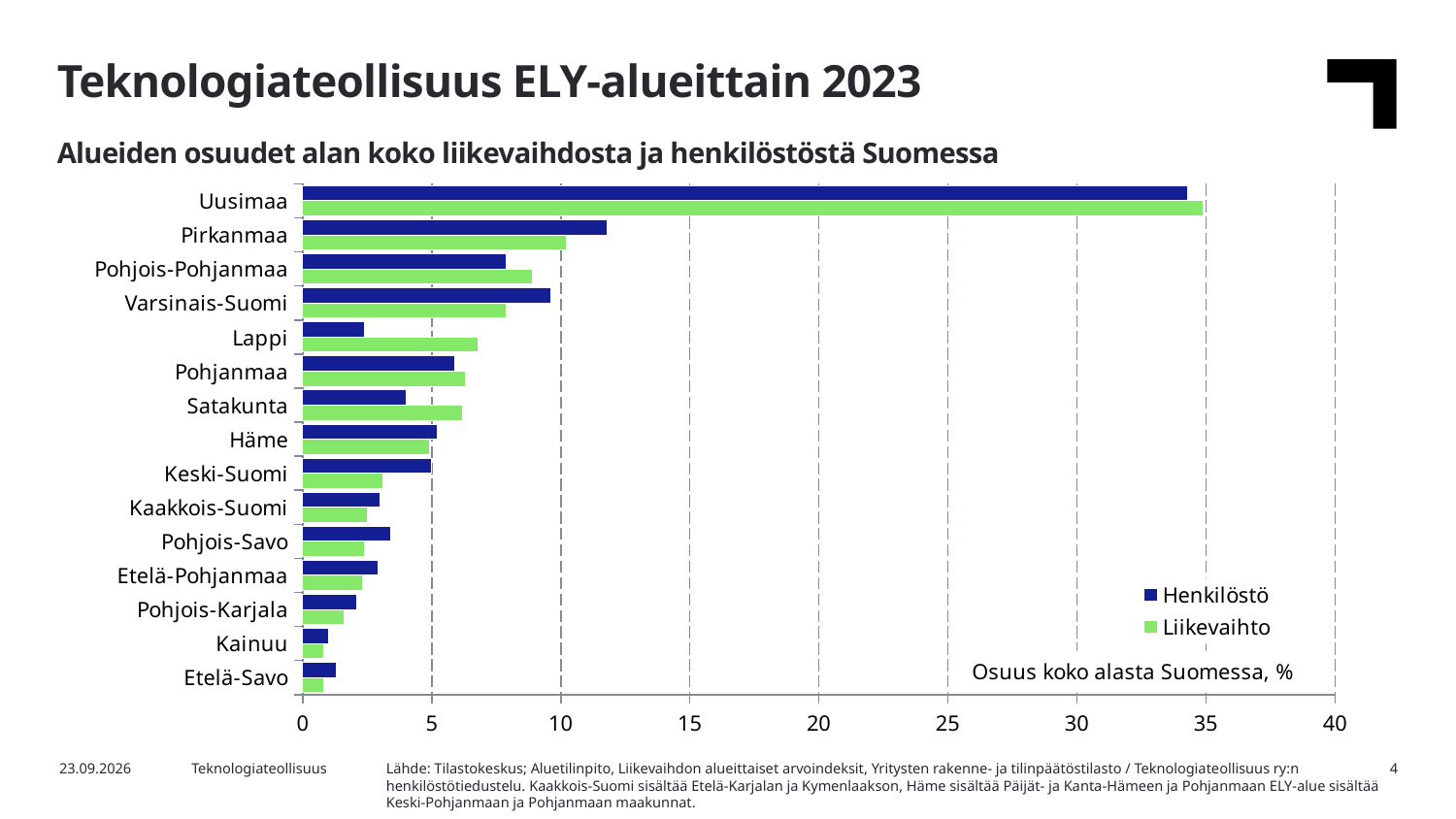
Is the Liikevaihto value for Lappi greater or less than 5? greater What kind of chart is shown on the slide? bar chart Is the Henkilöstö value for Pirkanmaa greater or less than 10? greater For Varsinais-Suomi, which is larger: the Henkilöstö share or the Liikevaihto share? Henkilöstö Is the Henkilöstö value for Uusimaa greater or less than 30? greater How many series does the legend list? 2 How many regions (categories) are plotted on the chart? 15 For Lappi, which is larger: the Henkilöstö share or the Liikevaihto share? Liikevaihto Which region has the highest Liikevaihto share? Uusimaa Which region has the highest Henkilöstö share? Uusimaa What colour represents the Henkilöstö series in the legend? blue